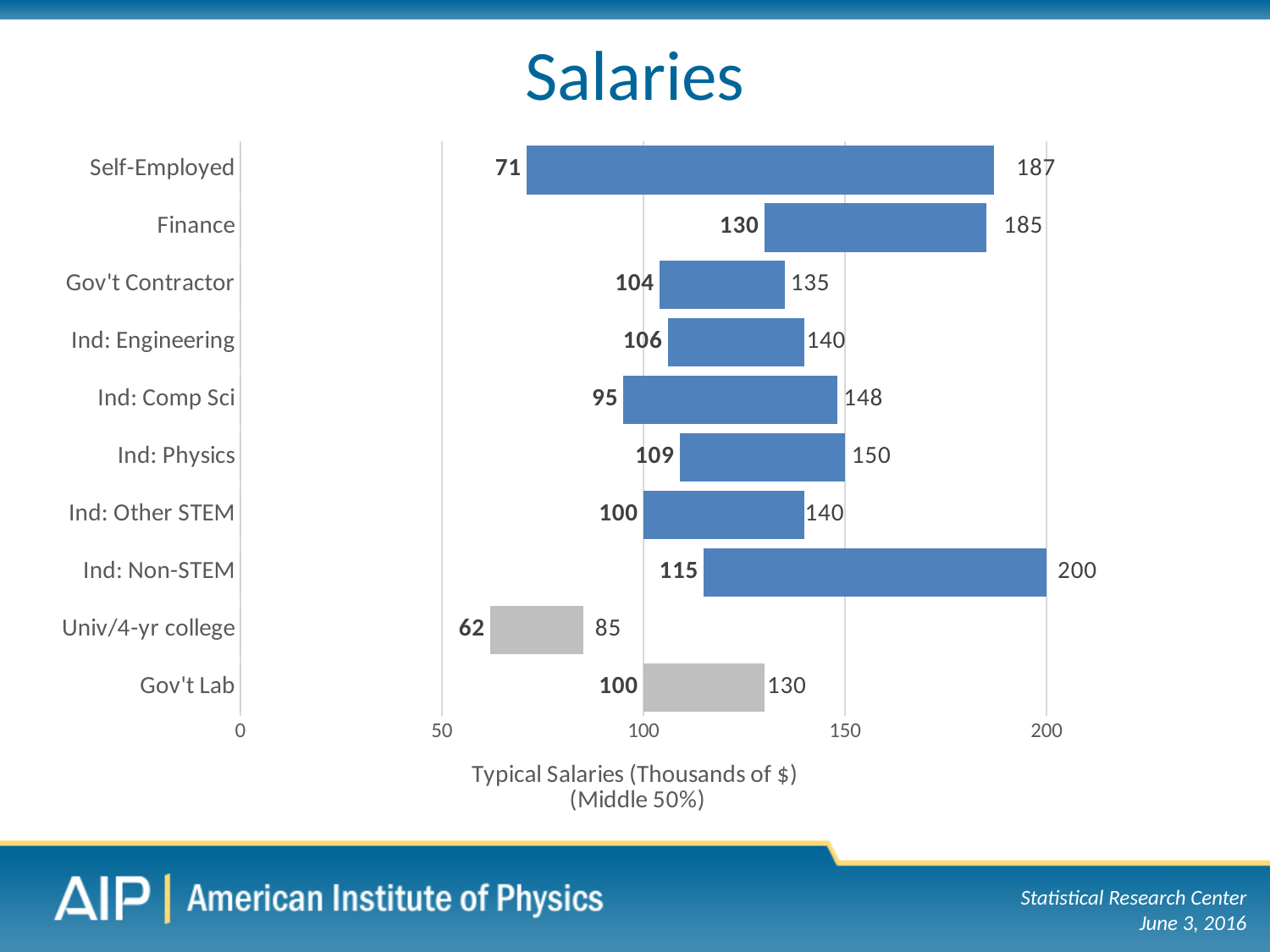
Which category has the highest upper salary value? Ind: Non-STEM What is the difference between the upper values for Finance and Gov't Lab? 55 What is the lower value of the salary range for Finance? 130 What is the difference between the upper and lower values for Ind: Comp Sci? 53 What is the x-axis label of the chart? Typical Salaries (Thousands of $) (Middle 50%) Which category has the lowest lower salary value? Univ/4-yr college What kind of chart is shown on the slide? Bar chart Is the lower value for Gov't Contractor greater or less than 100? greater How many categories are shown on the chart? 10 What is the upper value of the salary range for Univ/4-yr college? 85 What is the upper value of the salary range for Self-Employed? 187 Which has a higher upper salary value, Ind: Physics or Ind: Engineering? Ind: Physics